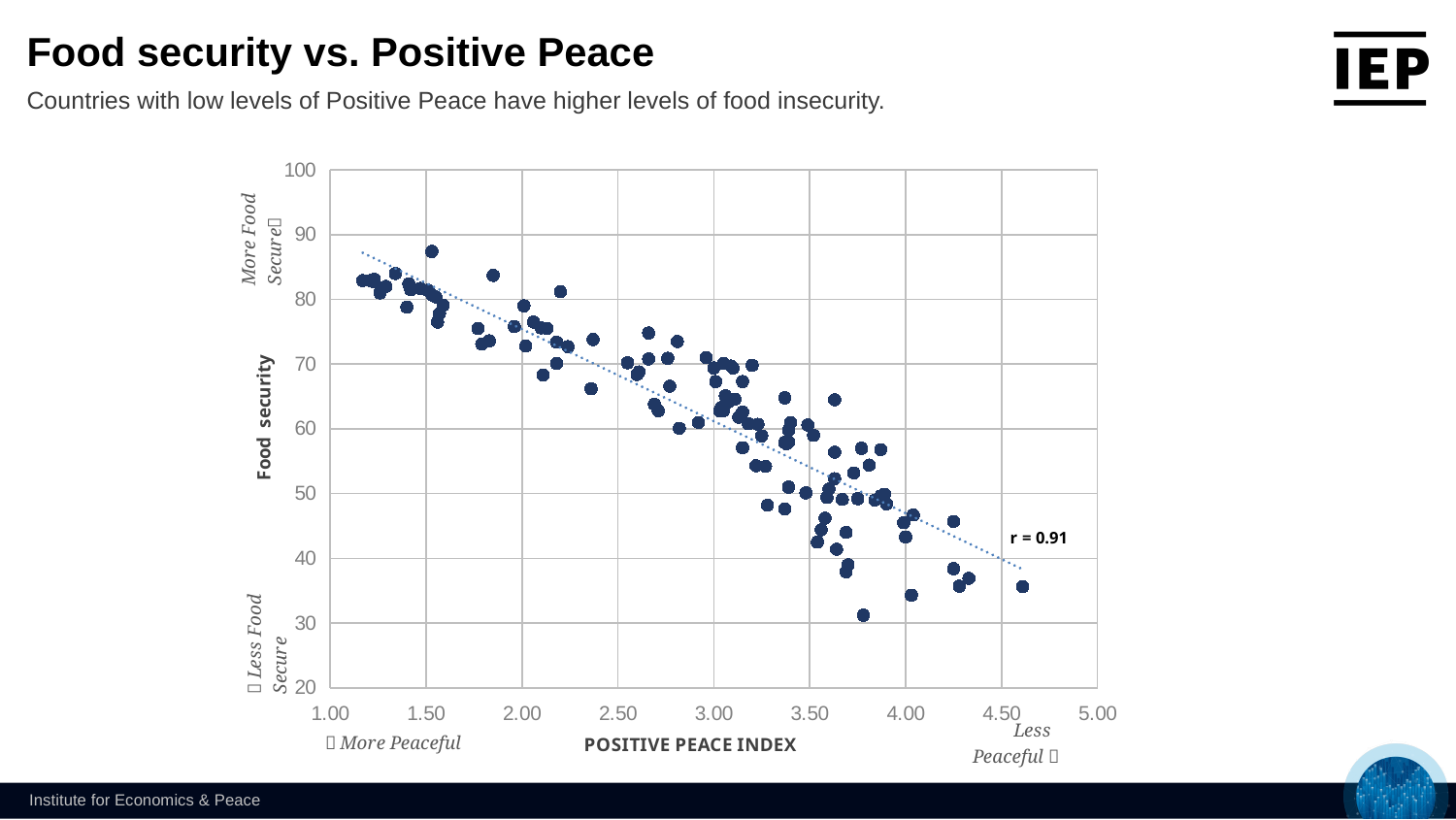
What correlation coefficient is printed on the chart? r = 0.91 Is the lowest plotted food security value greater or less than 40? less As the Positive Peace Index increases along the x axis, does food security rise or fall? Fall Do the points with a Positive Peace Index above 4.00 have food security values greater or less than 60? less Do the points with a Positive Peace Index below 1.50 have food security values greater or less than 70? greater What is the maximum value shown on the x axis (Positive Peace Index)? 5.00 What is the title of the chart? Food security vs. Positive Peace What is the minimum value shown on the y axis (Food security)? 20 What kind of chart is shown on the slide? Scatter plot